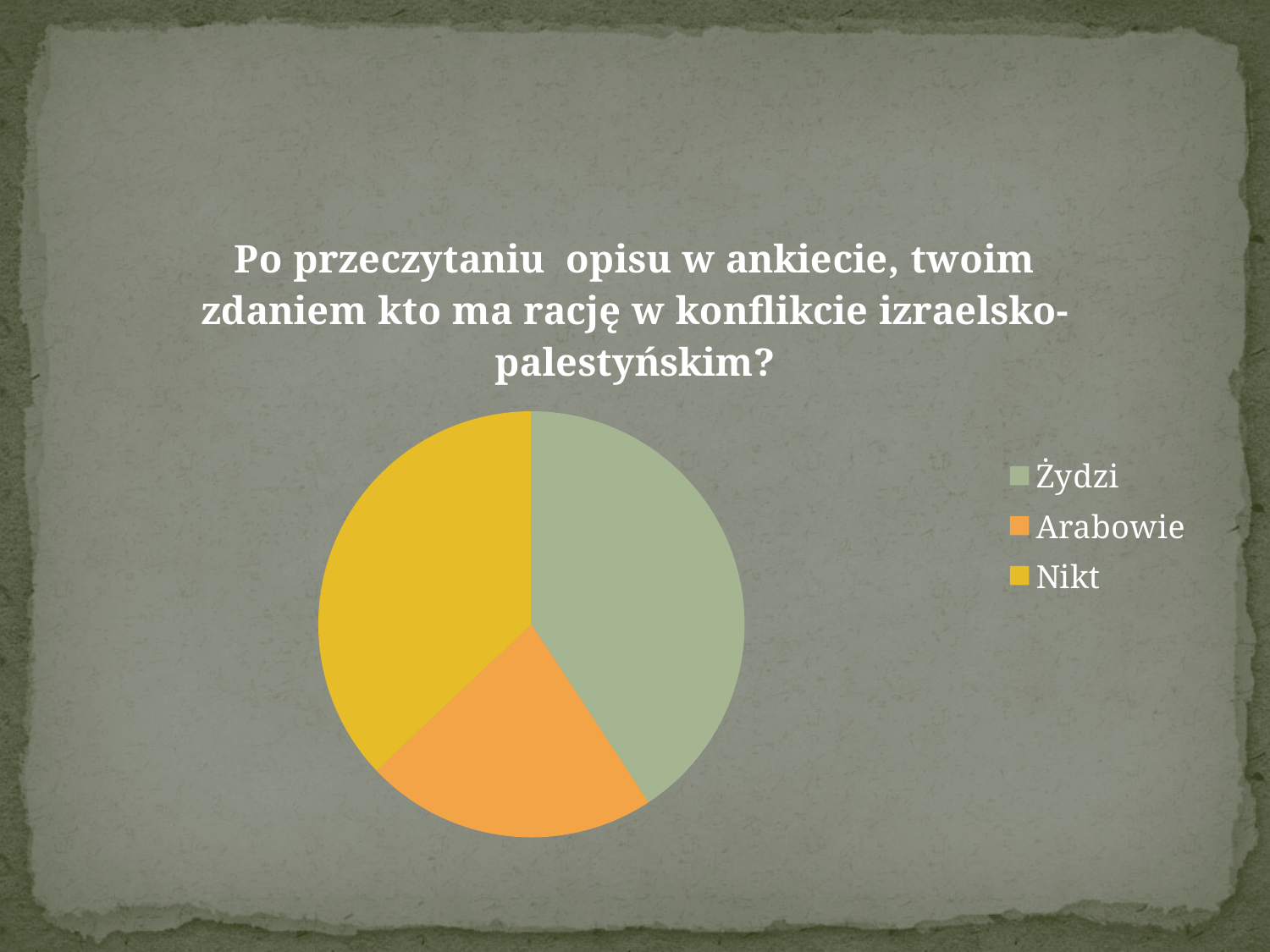
Which slice is larger in the pie chart, Żydzi or Arabowie? Żydzi What kind of chart is shown on the slide? pie chart Which category is shown in yellow in the pie chart? Nikt What colour is the Arabowie slice in the pie chart? orange Which slice is larger in the pie chart, Nikt or Arabowie? Nikt How many slices does the pie chart have? 3 How many entries does the legend of the pie chart list? 3 Which category has the smallest slice in the pie chart? Arabowie